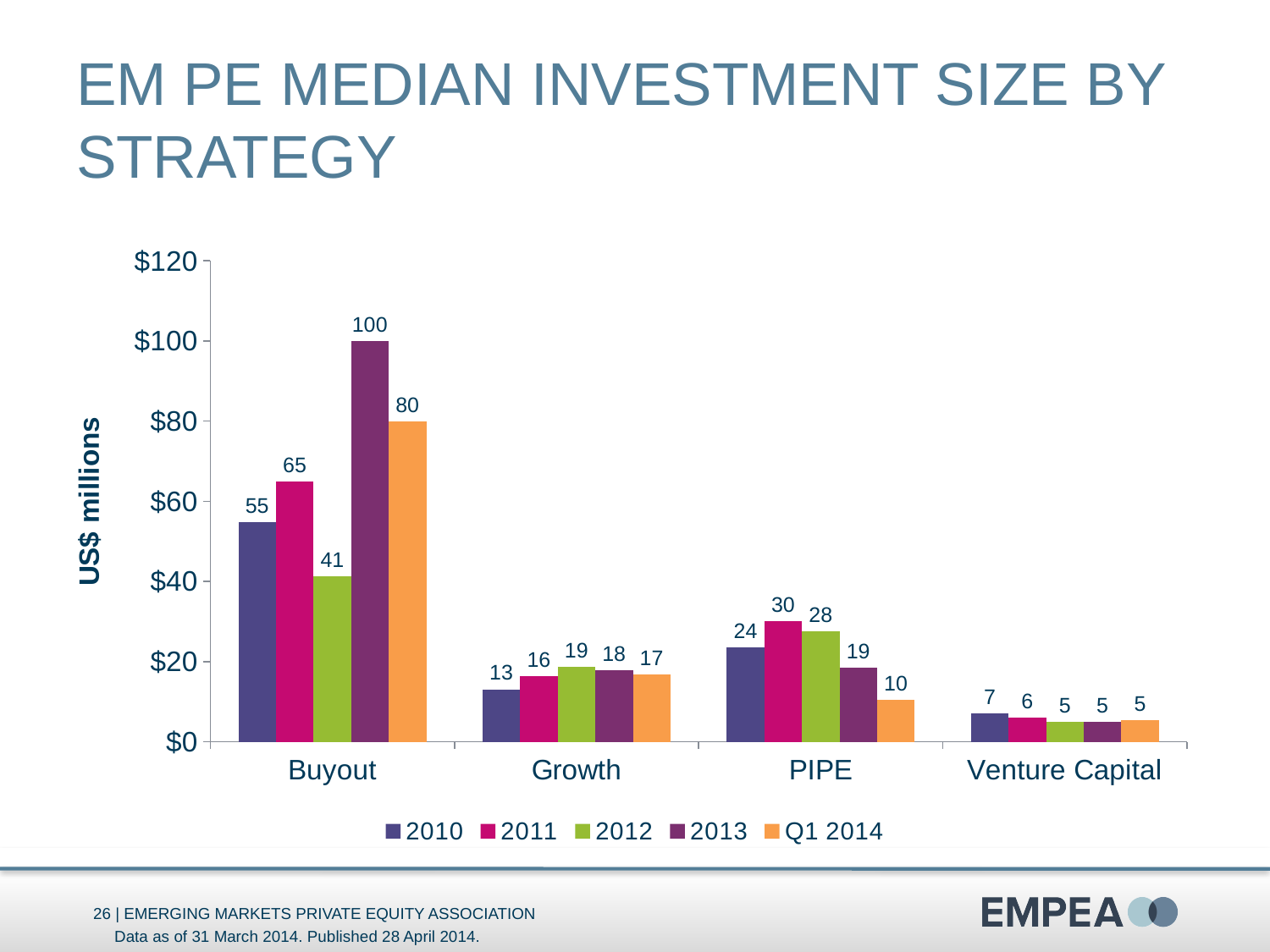
What is the median investment size for Buyout in 2013? 100 How many strategy categories are shown on the x axis? 4 Which strategy has the lowest median investment size in 2010? Venture Capital What is the median investment size for PIPE in Q1 2014? 10 Which strategy has the highest median investment size in 2011? Buyout What is the label on the vertical axis? US$ millions Which is larger for PIPE: the 2011 value or the 2012 value? 2011 How many series does the legend list? 5 What is the median investment size for Growth in 2012? 19 What is the difference between the Buyout values for 2013 and Q1 2014? 20 What kind of chart is shown on the slide? Bar chart Is the value for Buyout in 2012 greater or less than $40? greater